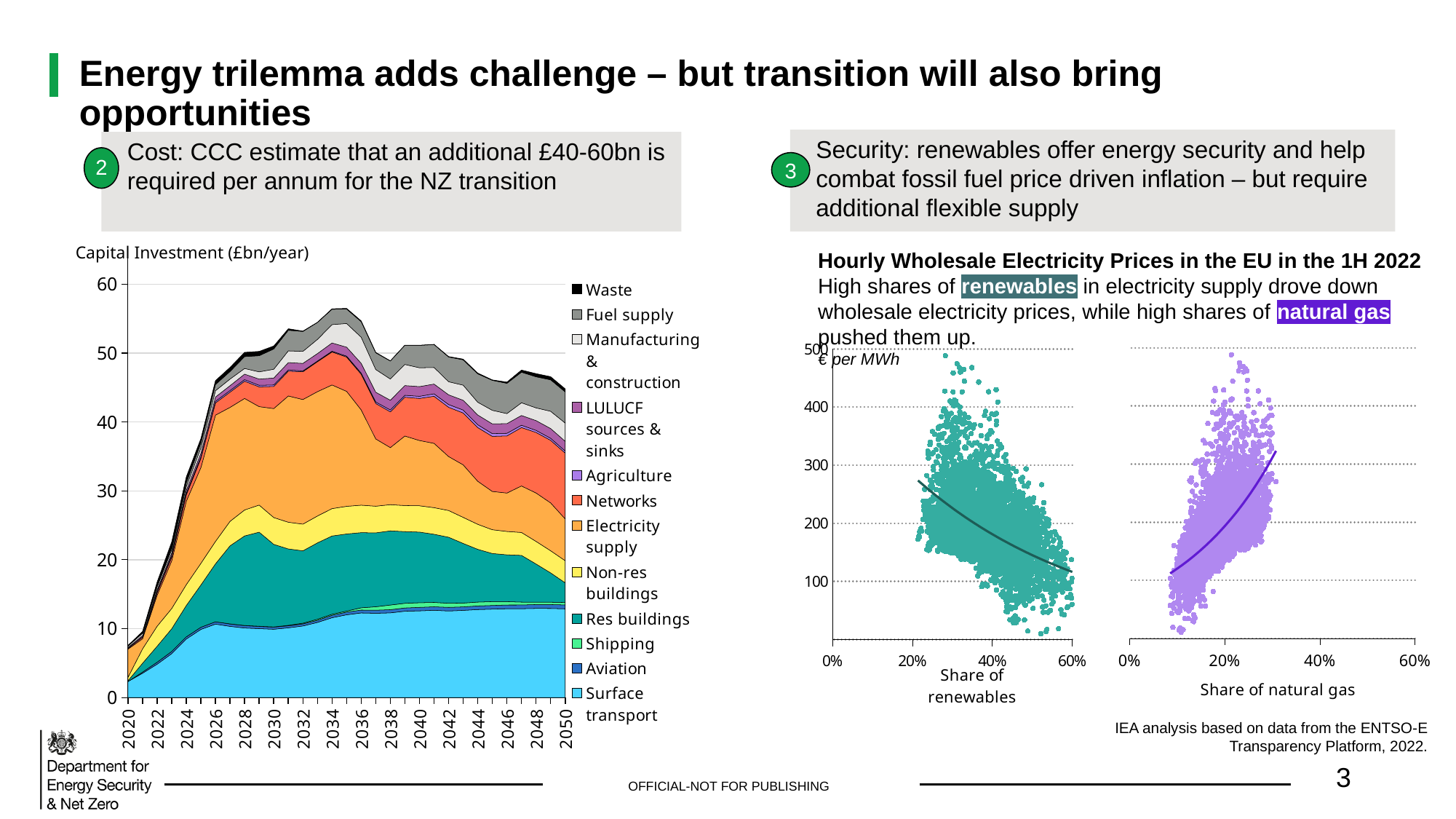
In the Capital Investment chart, is the total capital investment in 2034 greater or less than 50? greater What kind of chart is the Capital Investment chart on the left of the slide? Stacked area chart In the Hourly Wholesale Electricity Prices charts, do prices rise or fall as the share of renewables increases? fall In the Capital Investment chart, what unit is given in the chart title? £bn/year What is the unit of the y axis in the Hourly Wholesale Electricity Prices charts? € per MWh What kind of charts are the two Hourly Wholesale Electricity Prices charts on the right? Scatter plots In the Capital Investment chart, which series is shown at the bottom of the stack in light blue? Surface transport In the Hourly Wholesale Electricity Prices charts, do prices rise or fall as the share of natural gas increases? rise How many series does the legend of the Capital Investment chart list? 12 In the Capital Investment chart, is the total capital investment in 2050 greater or less than 40? greater In the Capital Investment chart, does total capital investment rise or fall between 2020 and 2026? rise In the Capital Investment chart, is the total capital investment in 2020 greater or less than 10? less